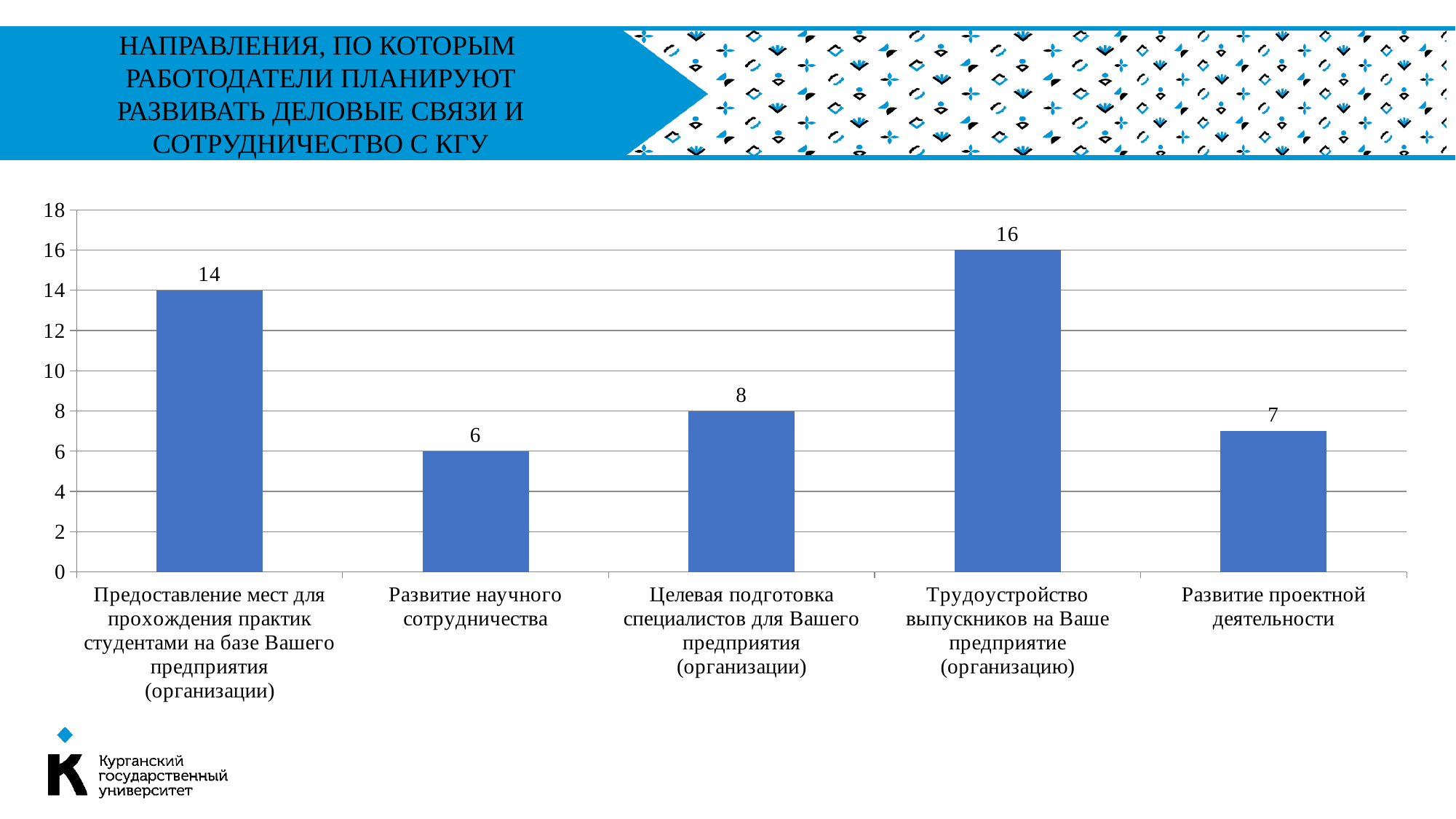
Which category has the lowest value? Развитие научного сотрудничества How many categories are shown in the chart? 5 What is the difference between the values for "Трудоустройство выпускников на Ваше предприятие (организацию)" and "Целевая подготовка специалистов для Вашего предприятия (организации)"? 8 What is the value for "Предоставление мест для прохождения практик студентами на базе Вашего предприятия (организации)"? 14 What is the maximum value shown on the vertical axis? 18 What kind of chart is shown on the slide? bar chart Which category has the highest value? Трудоустройство выпускников на Ваше предприятие (организацию) What is the value for "Развитие научного сотрудничества"? 6 What is the value for "Трудоустройство выпускников на Ваше предприятие (организацию)"? 16 What is the value for "Развитие проектной деятельности"? 7 Which is larger: the value for "Целевая подготовка специалистов для Вашего предприятия (организации)" or for "Развитие проектной деятельности"? Целевая подготовка специалистов для Вашего предприятия (организации) Is the value for "Предоставление мест для прохождения практик студентами на базе Вашего предприятия (организации)" greater or less than 10? greater